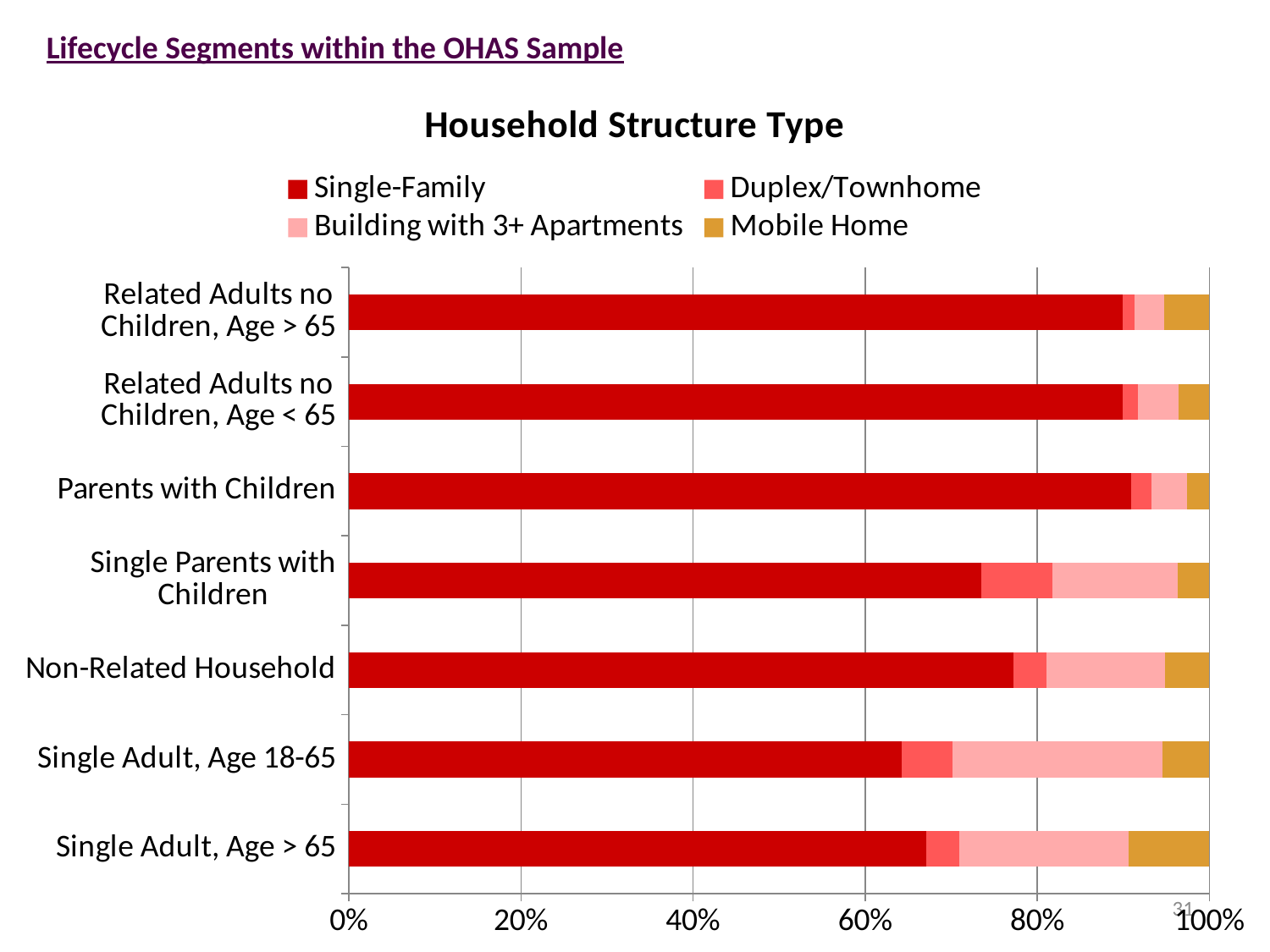
Which series is shown in the gold/orange colour in the legend? Mobile Home Which category has the largest Building with 3+ Apartments share? Single Adult, Age 18-65 Is the Single-Family share for Single Parents with Children greater or less than 60%? greater How many series does the legend list? 4 How many household categories are plotted on the chart? 7 Which category has the largest Mobile Home share? Single Adult, Age > 65 What kind of chart is shown on the slide? Stacked bar chart Is the Single-Family share for Single Adult, Age 18-65 greater or less than 80%? less What is the title of the chart? Household Structure Type Is the Single-Family share for Parents with Children greater or less than 80%? greater Which category has the smallest Single-Family share? Single Adult, Age 18-65 Which has the larger Single-Family share: Non-Related Household or Single Adult, Age 18-65? Non-Related Household